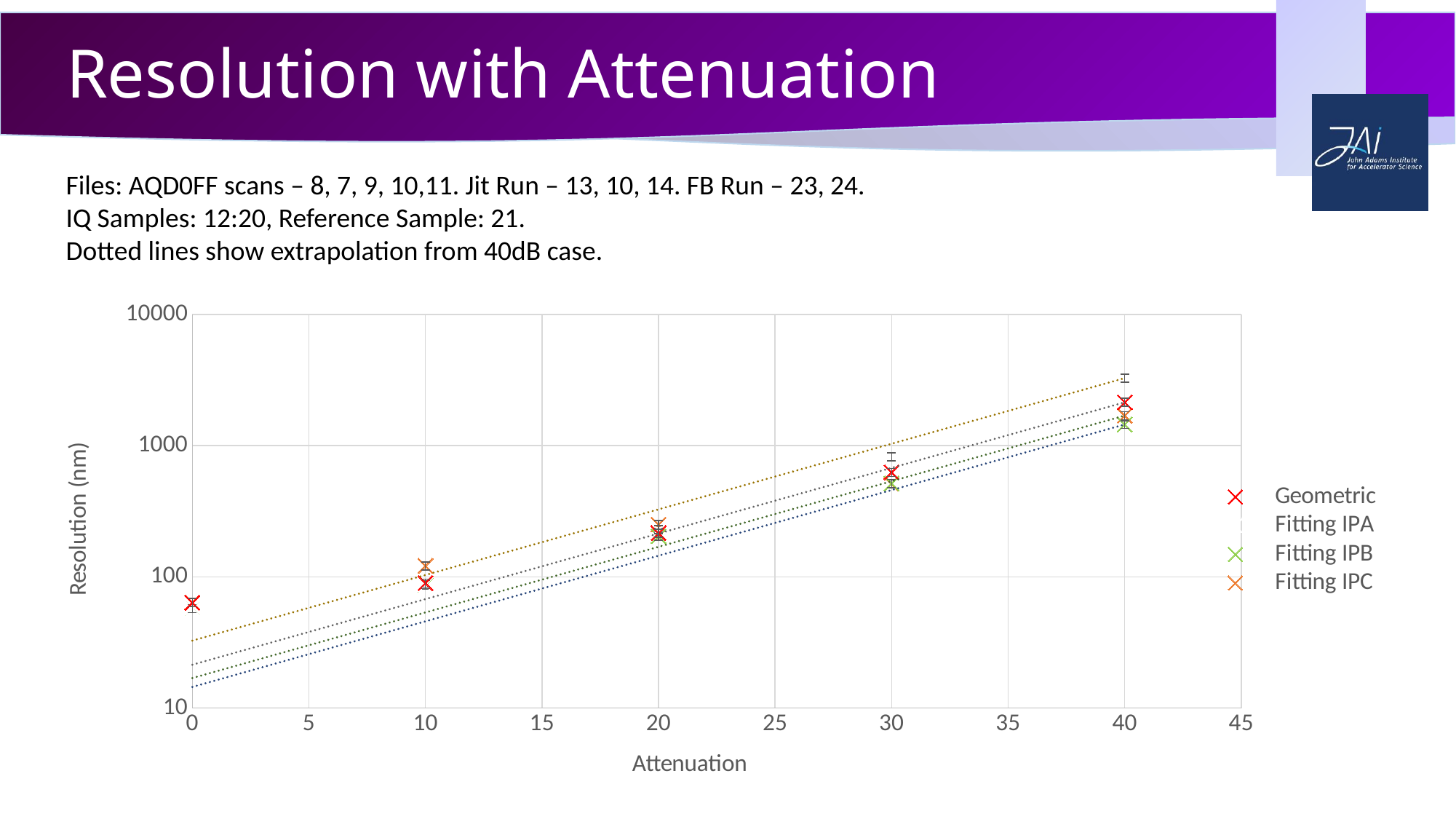
Is the Geometric resolution value at attenuation 40 greater or less than 1000? greater Is the Geometric resolution value at attenuation 0 greater or less than 100? less What is the label of the x axis of the chart? Attenuation What kind of chart is shown on the slide? scatter chart At how many attenuation values are data points plotted? 5 Do the resolution values rise or fall as attenuation increases along the x axis? rise Is the Geometric resolution value at attenuation 20 greater or less than 100? greater What is the label of the y axis of the chart? Resolution (nm) At which attenuation value is the plotted resolution highest? 40 At which attenuation value is the plotted resolution lowest? 0 How many series does the chart legend list? 4